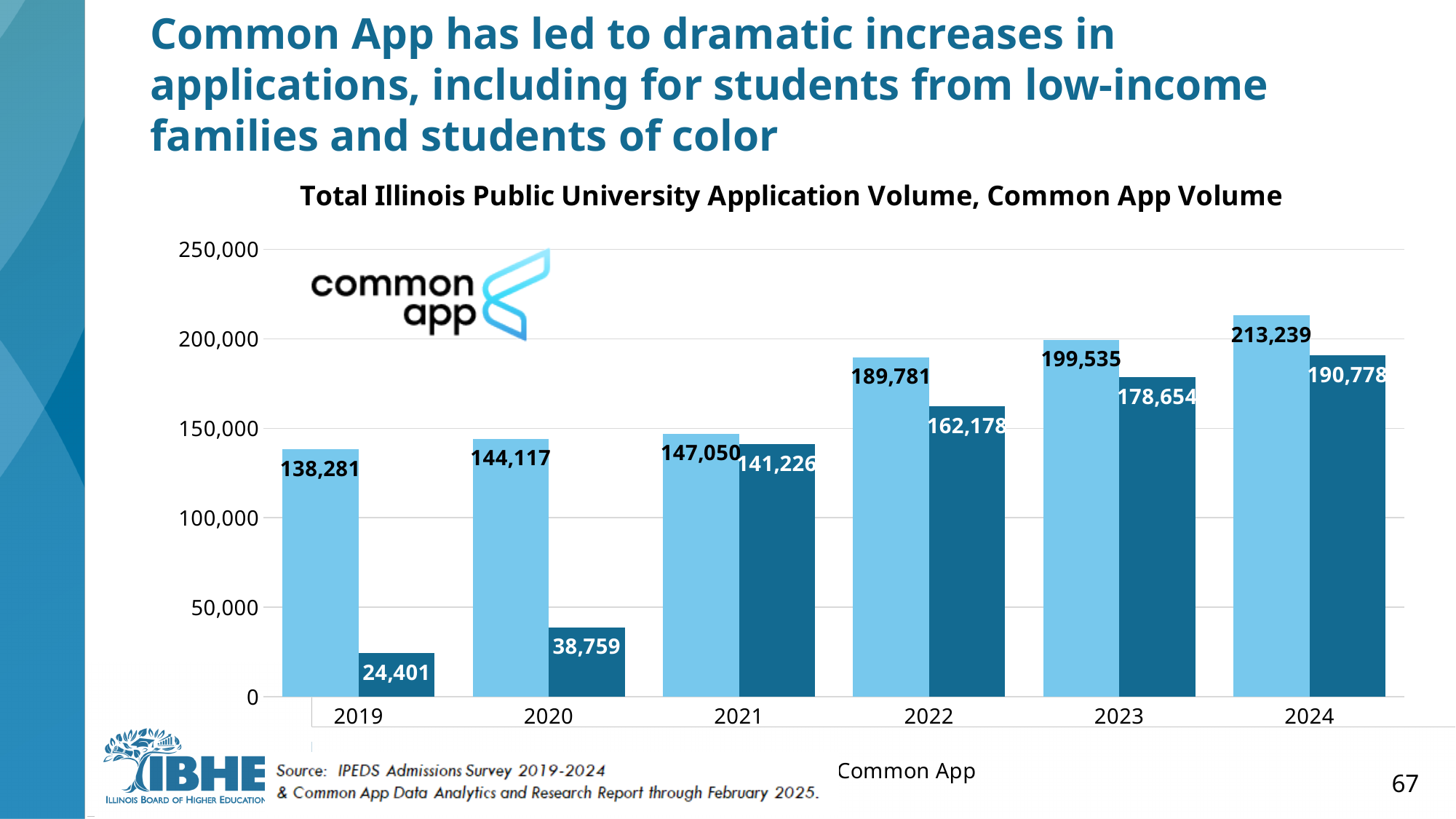
How many years are shown on the x axis? 6 What is the difference between the total application volume and the Common App volume in 2024? 22,461 By how much did the Common App volume increase from 2019 to 2024? 166,377 In which year was the total application volume highest? 2024 What was the Common App volume in 2024? 190,778 Does the Common App volume rise or fall from 2019 to 2024? Rise What was the Common App volume in 2020? 38,759 Which is larger: the Common App volume in 2021 or the Common App volume in 2020? 2021 In which year was the Common App volume lowest? 2019 What kind of chart is shown on the slide? Bar chart Is the total application volume in 2023 greater or less than 150,000? greater What was the total Illinois public university application volume in 2019? 138,281